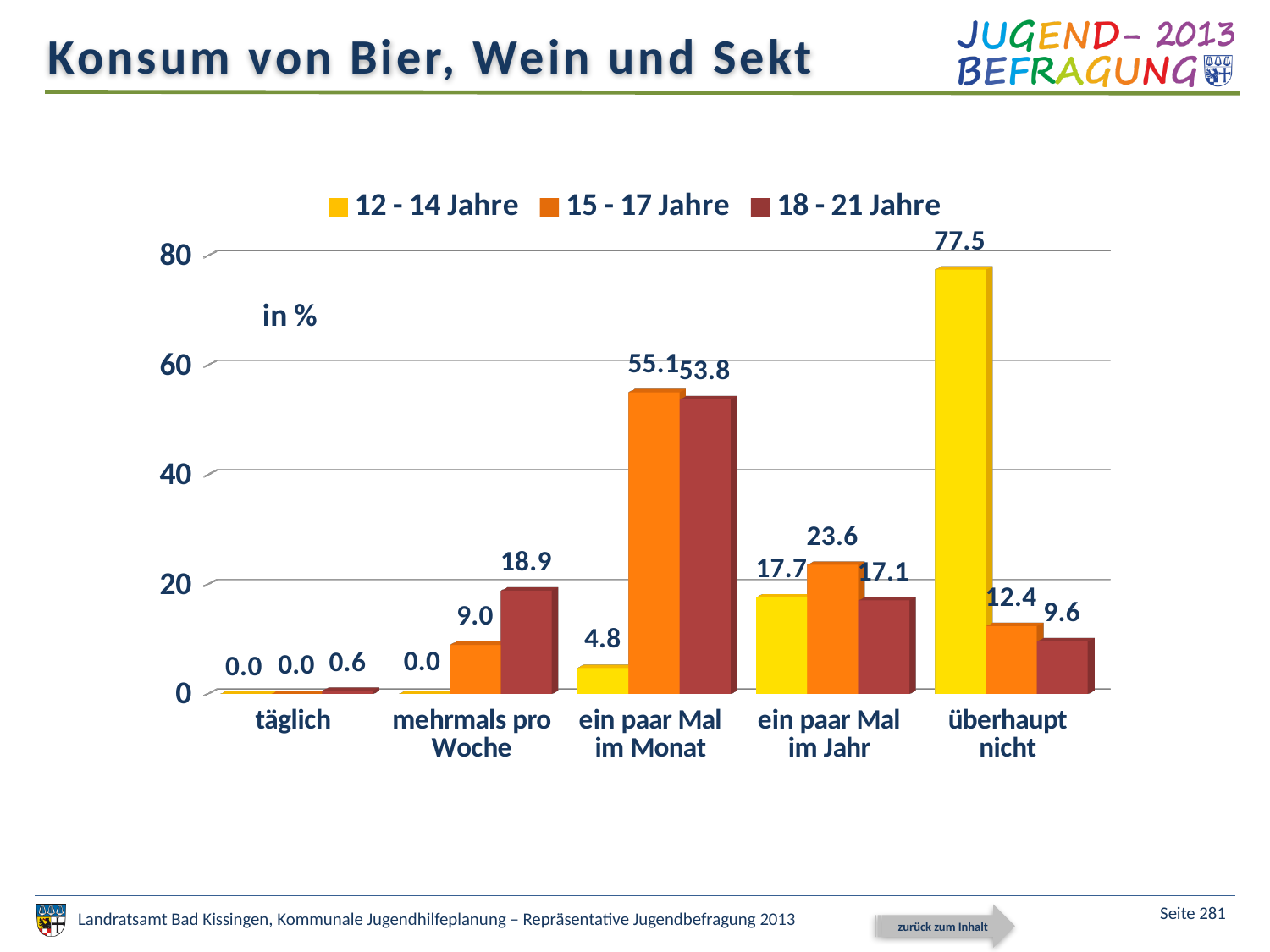
What is the difference between the 15 - 17 Jahre and 18 - 21 Jahre values in the category 'überhaupt nicht'? 2.8 How many categories are shown on the x axis? 5 What is the value for 18 - 21 Jahre in the category 'mehrmals pro Woche'? 18.9 What is the value for 12 - 14 Jahre in the category 'ein paar Mal im Monat'? 4.8 What unit is indicated for the values on the chart? in % Which category has the highest value for the 15 - 17 Jahre series? ein paar Mal im Monat How many series does the legend list? 3 In the category 'ein paar Mal im Jahr', which is larger: the value for 12 - 14 Jahre or for 18 - 21 Jahre? 12 - 14 Jahre What is the value for 15 - 17 Jahre in the category 'ein paar Mal im Jahr'? 23.6 Which category has the lowest value for the 18 - 21 Jahre series? täglich What is the value for 12 - 14 Jahre in the category 'überhaupt nicht'? 77.5 What kind of chart is shown on the slide? bar chart